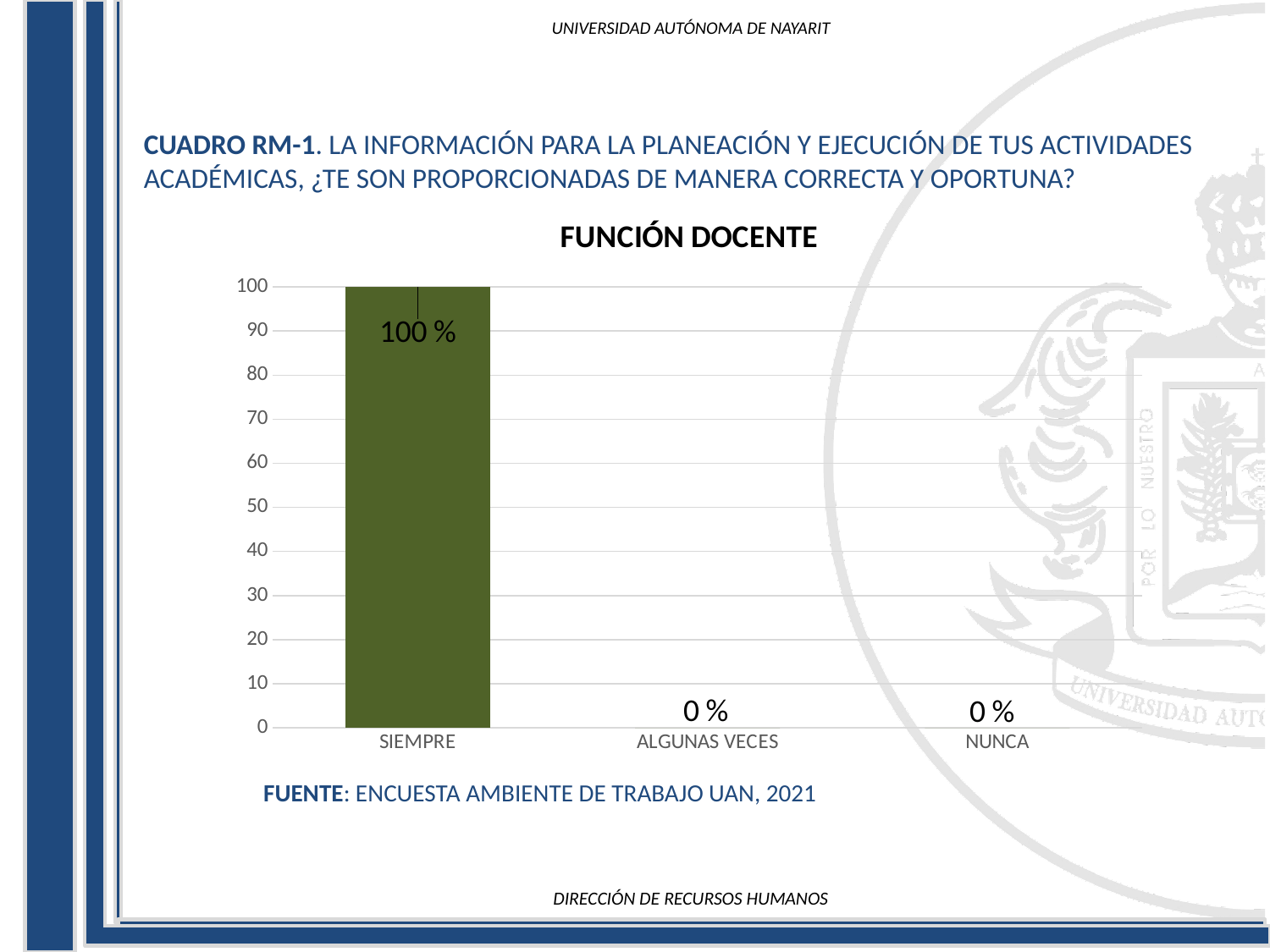
What kind of chart is shown? bar chart What is the title of the chart? FUNCIÓN DOCENTE How many categories are shown on the x axis? 3 What is the value for SIEMPRE? 100 % Which category has the highest value? SIEMPRE Do the values rise or fall from SIEMPRE to NUNCA along the x axis? fall What is the value for NUNCA? 0 % Is the value for SIEMPRE greater or less than 50? greater What is the value for ALGUNAS VECES? 0 % Which is larger, the value for SIEMPRE or the value for ALGUNAS VECES? SIEMPRE What is the highest value shown on the y axis? 100 What is the difference between the values for SIEMPRE and NUNCA? 100 %